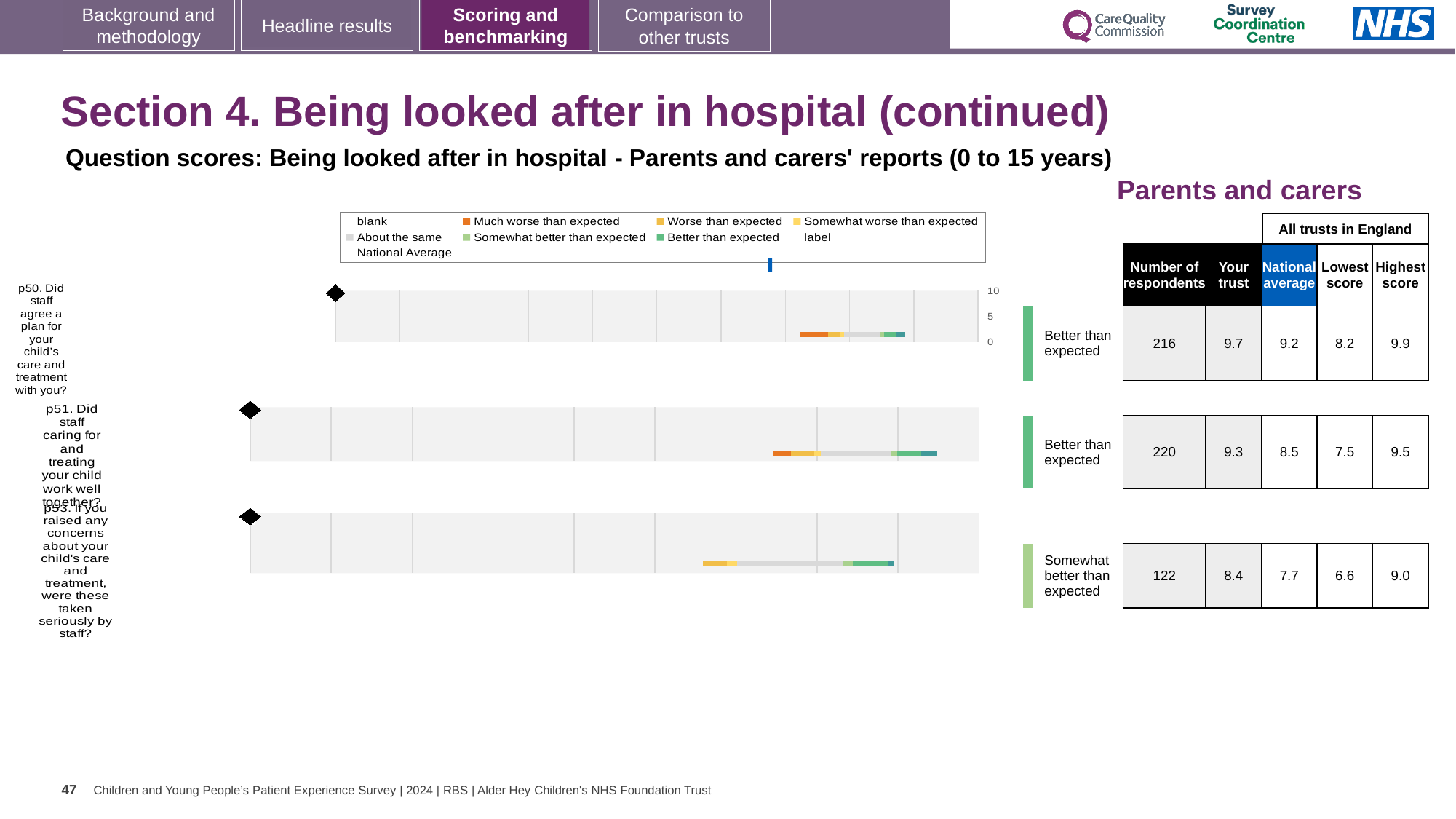
Which question has the lowest 'Lowest score' among all trusts in England? p53 By how much does the 'Your trust' score for p53 exceed the national average for p53? 0.7 Which question has the higher 'Your trust' score, p50 or p53? p50 How many questions (p50, p51, p53) are plotted as separate bars on the slide? 3 What is the highest tick value shown on the score axis of the charts? 10 What colour does the legend use for 'Much worse than expected'? orange What kind of chart is used to show the question scores on this slide? bar chart What is the highest score across all trusts in England for p51? 9.5 What is the 'Your trust' score for p50 (Did staff agree a plan for your child's care and treatment with you?)? 9.7 How many respondents answered p53 (If you raised any concerns about your child's care and treatment, were these taken seriously by staff?)? 122 Which question has the largest number of respondents? p51 What is the national average score for p51 (Did staff caring for and treating your child work well together?)? 8.5